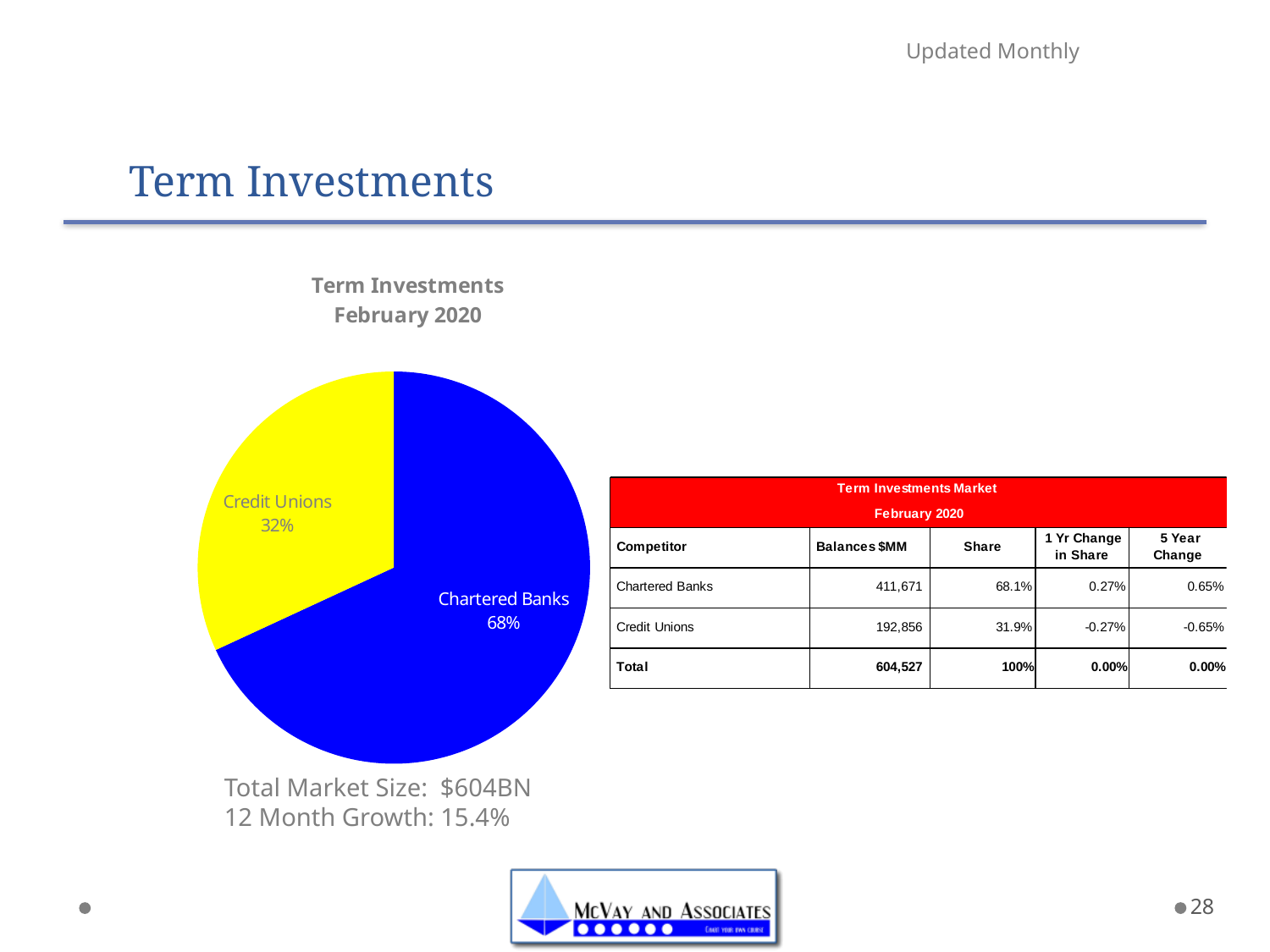
Which is larger in the pie chart, Chartered Banks or Credit Unions? Chartered Banks What share of the pie chart does Chartered Banks hold? 68% What share of the pie chart does Credit Unions hold? 32% How many slices does the pie chart have? 2 Is the Chartered Banks share in the pie chart greater or less than 50%? greater Which slice of the pie chart is the smallest? Credit Unions What type of chart is shown on the slide? pie chart What colour is the Credit Unions slice in the pie chart? yellow What is the difference in percentage points between the Chartered Banks slice and the Credit Unions slice? 36 What is the title of the pie chart? Term Investments February 2020 Which slice of the pie chart is the largest? Chartered Banks